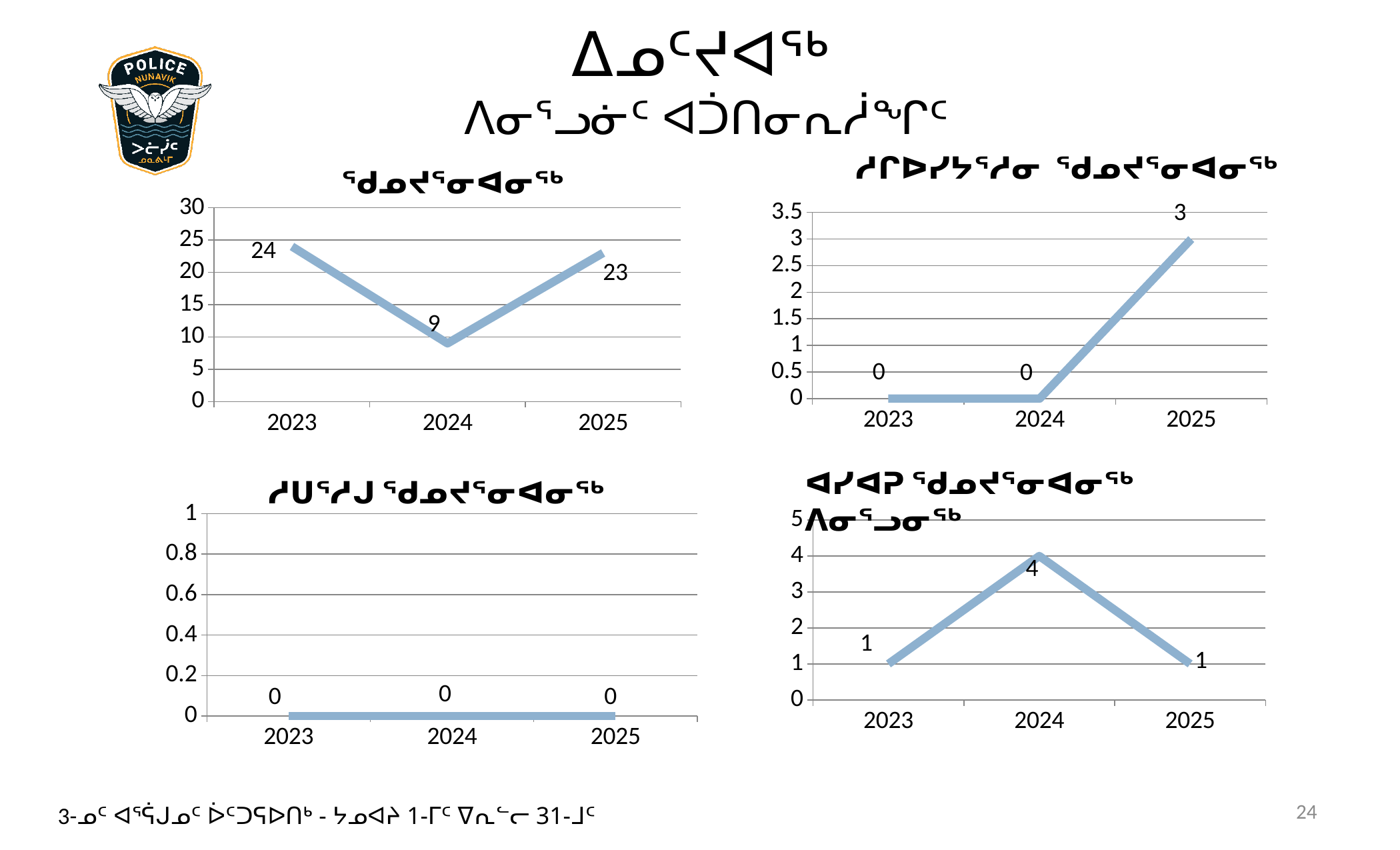
In the top-left chart, what is the difference between the 2023 and 2025 values? 1 In the bottom-left chart, what is the value for 2025? 0 In the top-left chart, what is the value for 2023? 24 How many years are shown on the x axis of the bottom-right chart? 3 In the top-left chart, what is the value for 2024? 9 In the bottom-right chart, what is the value for 2024? 4 In the bottom-right chart, is the value for 2024 larger than the value for 2025? Yes In the top-right chart, what is the value for 2024? 0 In the top-right chart, which year has the highest value? 2025 In the top-right chart, what is the value for 2025? 3 In the top-left chart, which year has the lowest value? 2024 What kind of chart is the top-left chart? Line chart